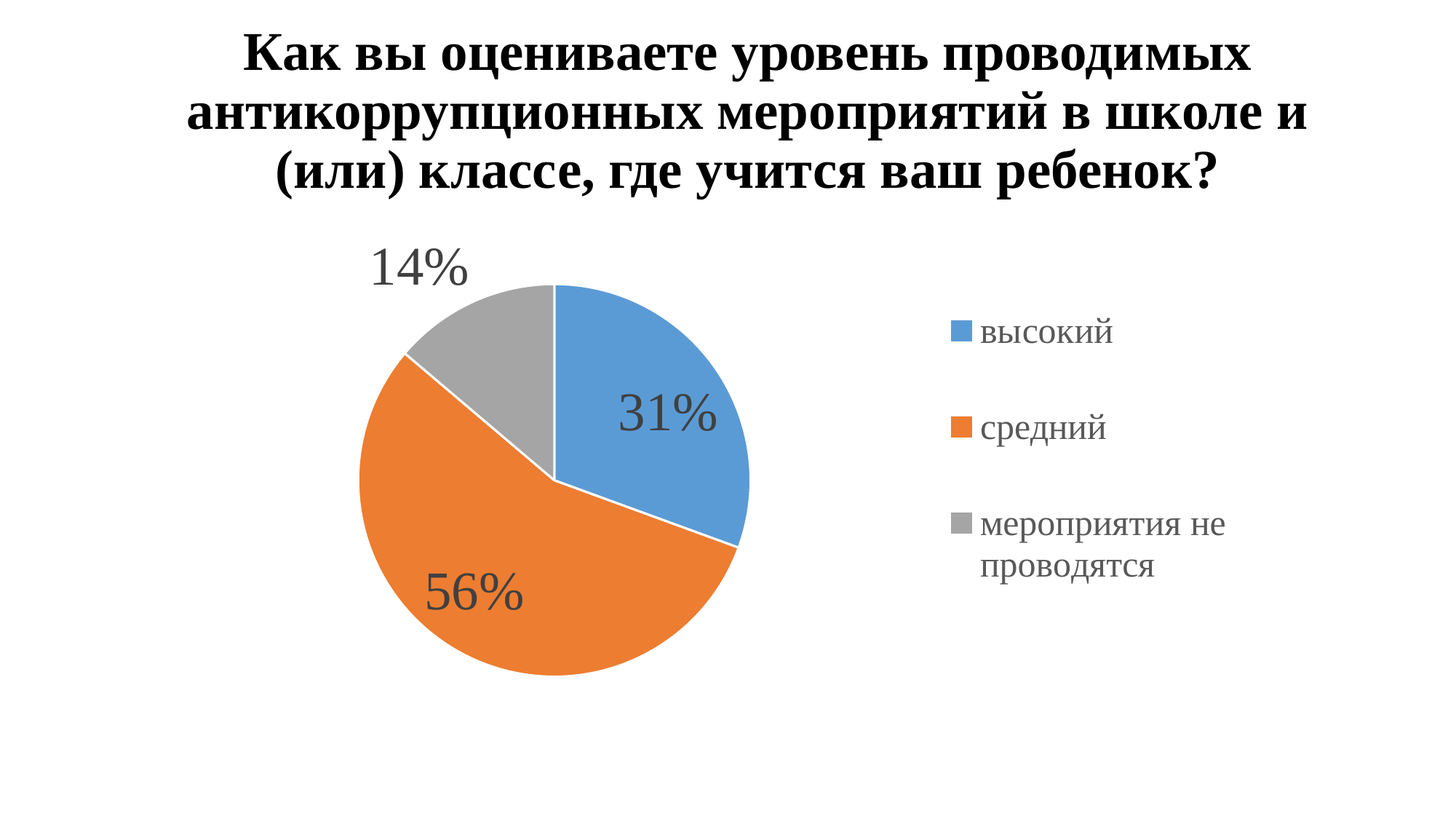
Which slice is larger, "высокий" or "мероприятия не проводятся"? высокий What kind of chart is shown on the slide? pie chart Which category has the largest slice of the pie? средний What share of the pie is labelled "мероприятия не проводятся"? 14% What share of the pie is labelled "средний"? 56% Which category has the smallest slice of the pie? мероприятия не проводятся What colour is the slice for "средний"? orange What is the difference in percentage points between the "высокий" and "мероприятия не проводятся" slices? 17 What share of the pie is labelled "высокий"? 31% How many entries does the legend list? 3 How many slices does the pie chart have? 3 What is the difference in percentage points between the "средний" and "высокий" slices? 25